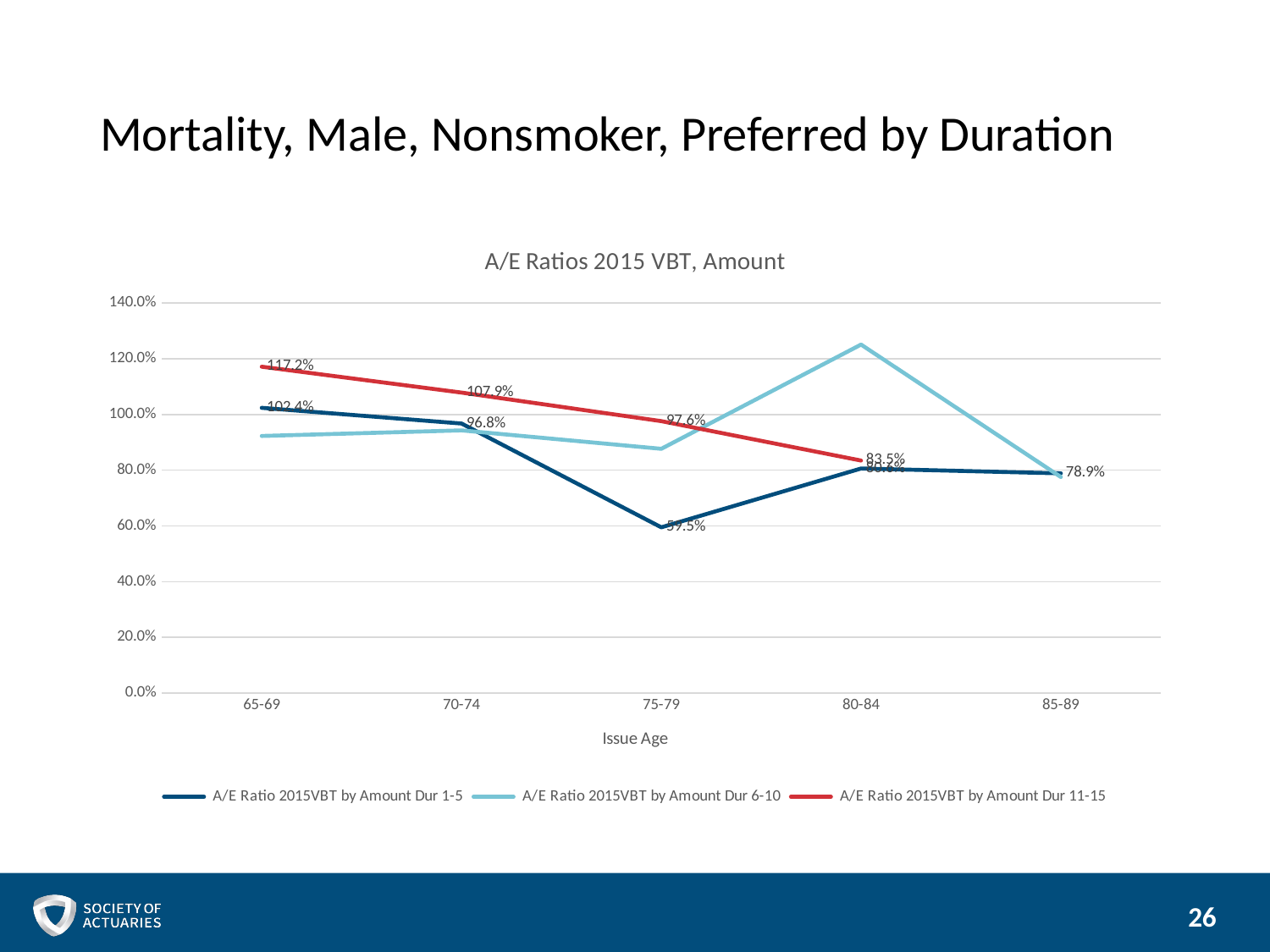
At which issue age does the Dur 11-15 series reach its highest value? 65-69 What is the A/E Ratio 2015VBT by Amount Dur 1-5 value for issue age 75-79? 59.5% What is the A/E Ratio 2015VBT by Amount Dur 1-5 value for issue age 85-89? 78.9% What type of chart is shown on the slide? line chart What is the A/E Ratio 2015VBT by Amount Dur 11-15 value for issue age 70-74? 107.9% How many series does the legend list? 3 What is the difference between the Dur 11-15 values at issue age 65-69 and issue age 80-84? 33.7 percentage points At which issue age does the Dur 1-5 series reach its lowest value? 75-79 Is the Dur 6-10 value at issue age 80-84 greater or less than 120.0%? greater At issue age 70-74, which series is higher: Dur 1-5 or Dur 11-15? Dur 11-15 Does the Dur 11-15 series rise or fall as issue age increases? falls What is the A/E Ratio 2015VBT by Amount Dur 11-15 value for issue age 65-69? 117.2%